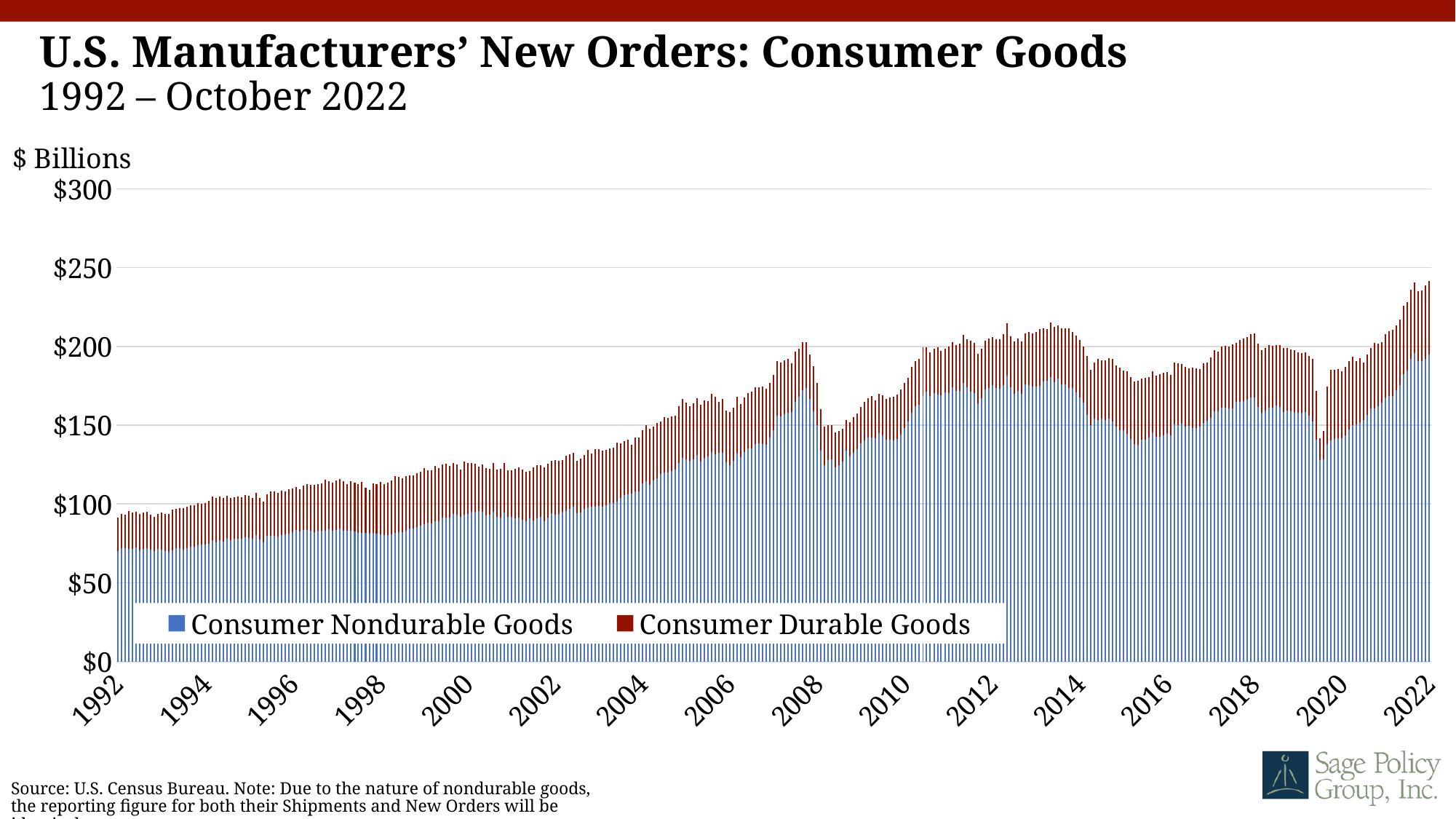
Is the total value of consumer goods new orders at the start of 1992 greater or less than $100? less What unit is shown on the y axis? $ Billions What are the two series shown in the legend? Consumer Nondurable Goods and Consumer Durable Goods In which year shown on the x axis does the total reach its highest level? 2022 Is the Consumer Nondurable Goods value at the start of 1992 greater or less than $50? greater Is the total value of consumer goods new orders larger in 1992 or in 2022? 2022 Is the Consumer Nondurable Goods value at the end of the series in 2022 greater or less than $150? greater What kind of chart is shown on the slide? Stacked bar chart Overall, do total consumer goods new orders rise or fall from 1992 to 2022? Rise Which series is larger in 2022, Consumer Nondurable Goods or Consumer Durable Goods? Consumer Nondurable Goods How many series does the legend list? 2